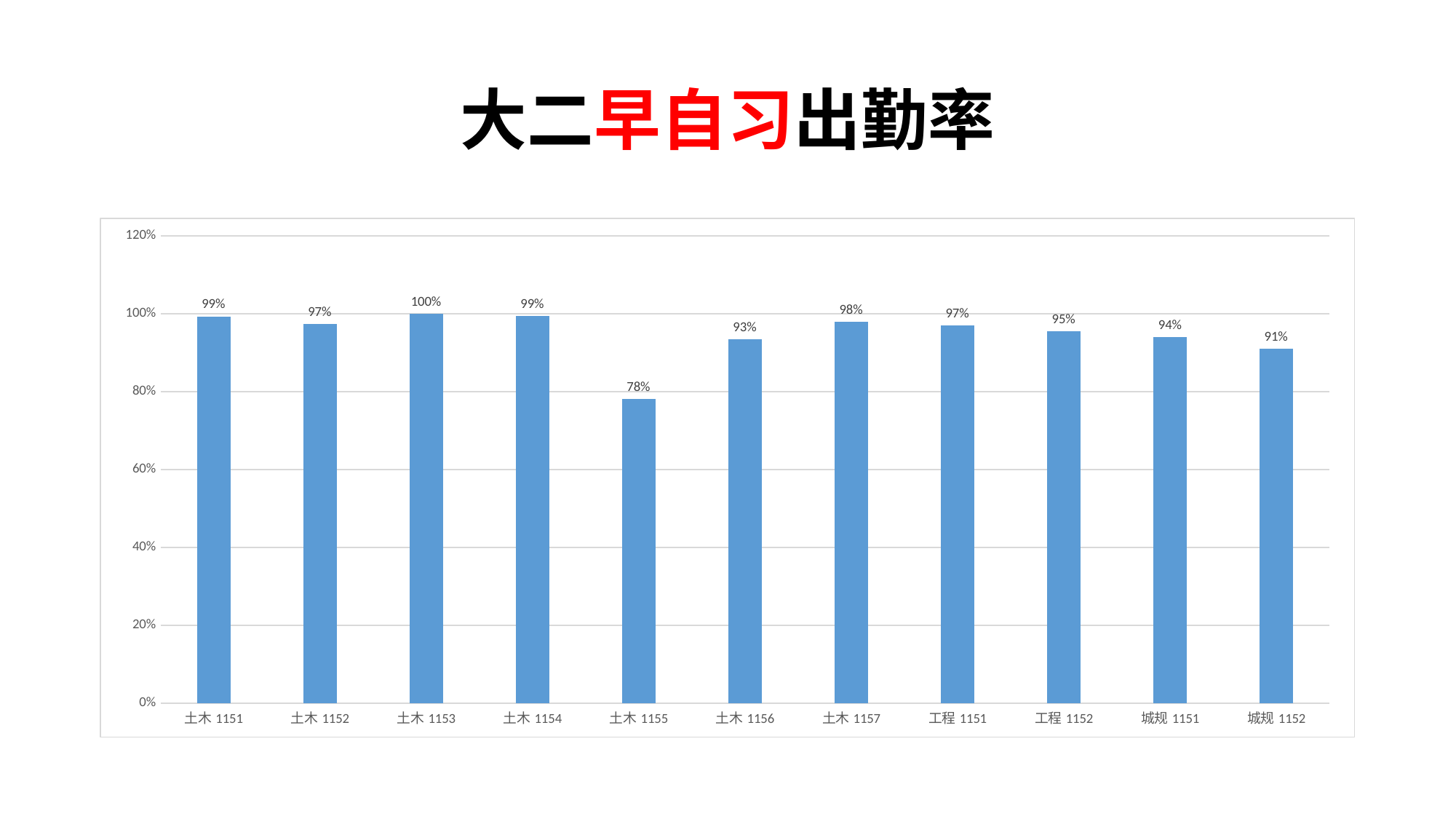
Is the value for 土木 1155 greater or less than 80%? less How many classes are shown in the chart? 11 Which class has the lowest attendance rate? 土木 1155 What is the title of the slide? 大二早自习出勤率 What is the difference between the attendance rates of 土木 1157 and 城规 1151? 4% What kind of chart is shown on the slide? bar chart What is the attendance rate for 城规 1152? 91% What is the attendance rate for 土木 1155? 78% What is the attendance rate for 工程 1152? 95% Which class has the highest attendance rate? 土木 1153 What is the difference between the attendance rates of 土木 1153 and 土木 1155? 22% Which has a higher attendance rate, 土木 1156 or 工程 1151? 工程 1151